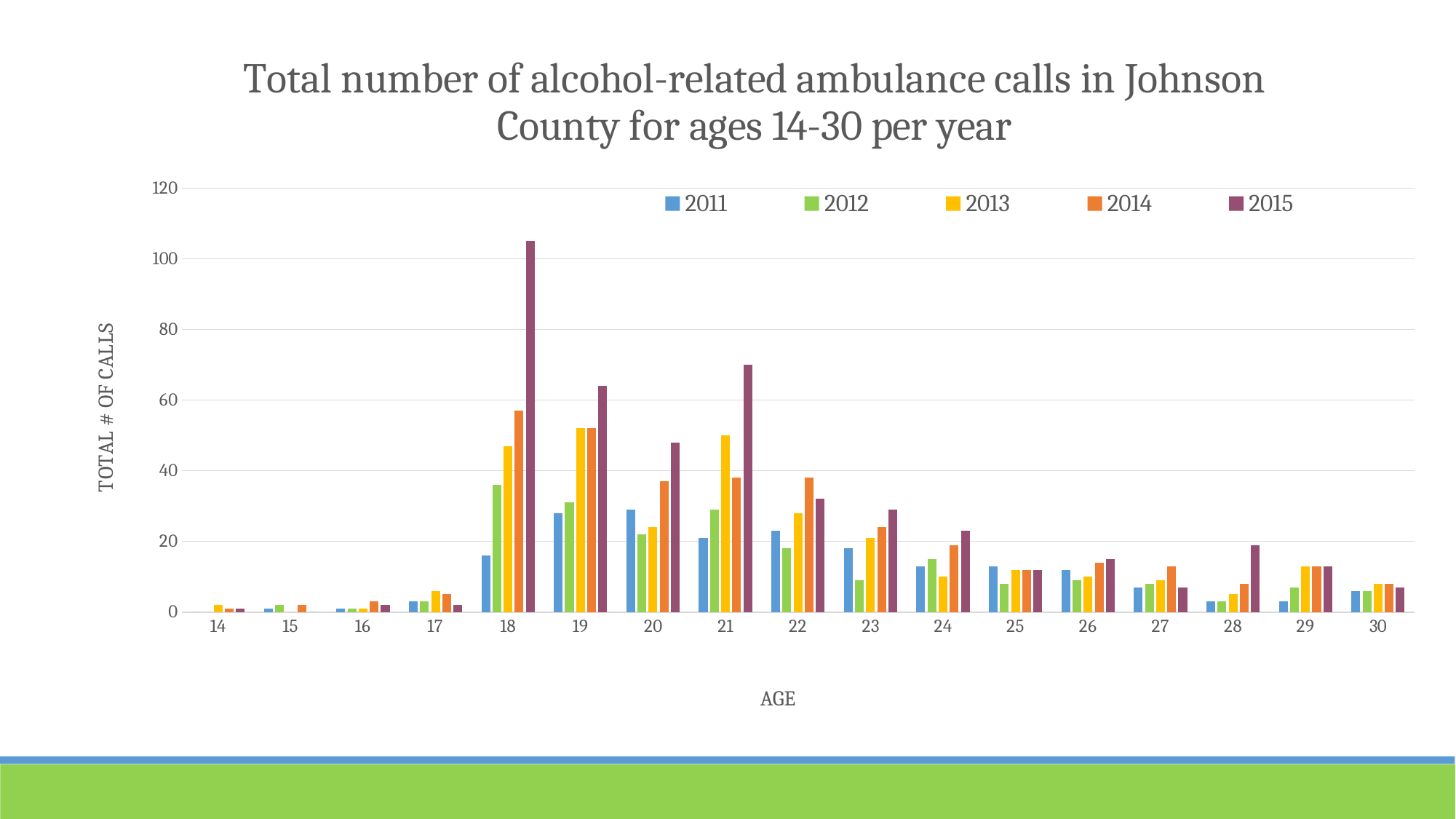
How many age categories are shown on the x axis? 17 What kind of chart is shown on the slide? bar chart Is the 2015 value for age 21 greater or less than 60? greater Is the 2011 value for age 20 greater or less than 40? less How many series does the legend list? 5 What is the title of the vertical axis? TOTAL # OF CALLS For the 2015 series, which age has the highest number of calls? 18 At age 18, which year has the lowest number of calls? 2011 Is the 2015 value for age 18 greater or less than 100? greater Do the 2015 values rise or fall from age 21 to age 25? fall At age 22, which is larger: the 2014 value or the 2012 value? 2014